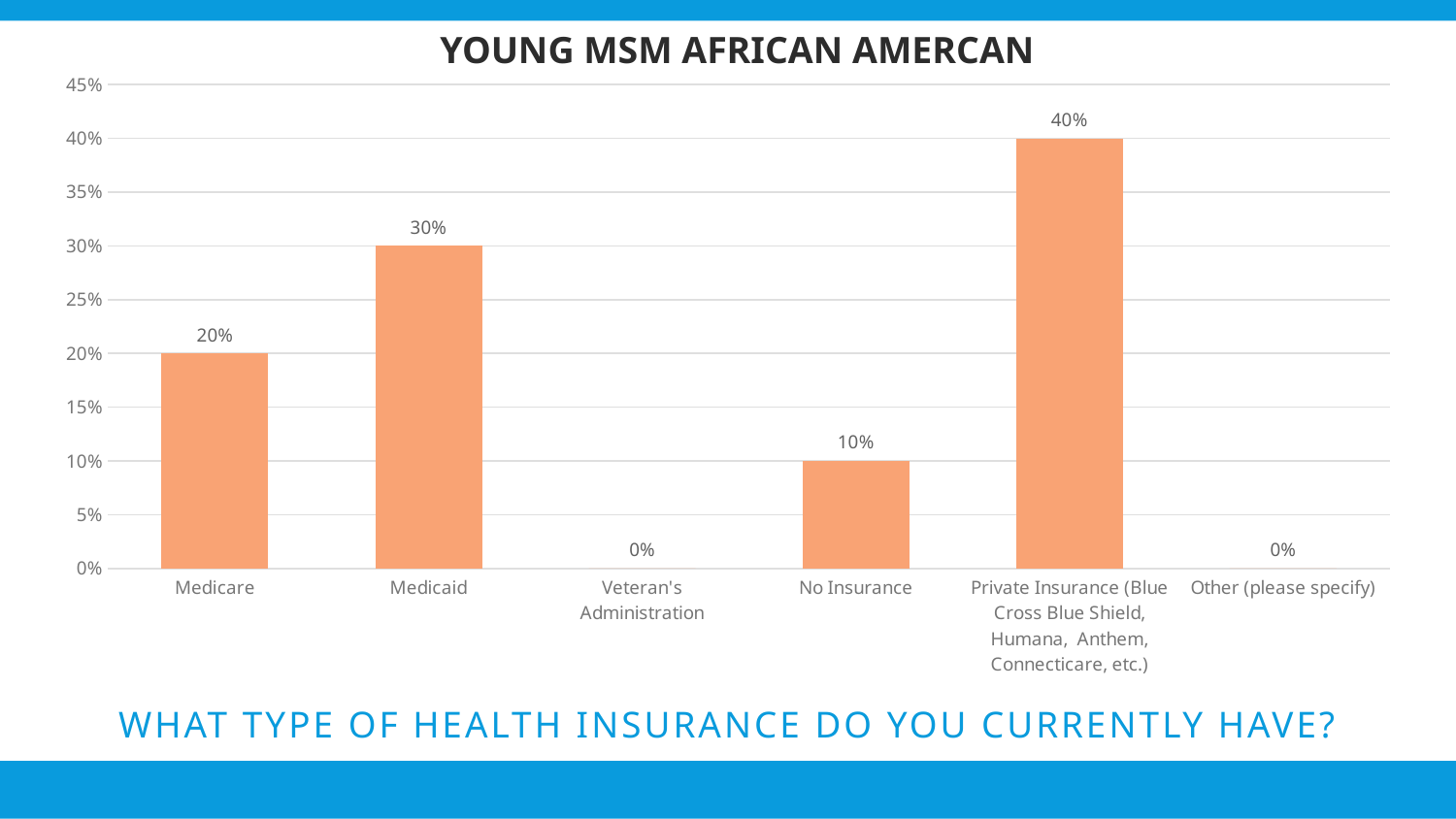
What is the value for No Insurance? 10% What is the value for Veteran's Administration? 0% What is the value for Medicaid? 30% How many categories are shown on the x axis? 6 What is the difference between the values for Private Insurance and Medicaid? 10% What kind of chart is shown on the slide? Bar chart What is the difference between the values for Medicare and No Insurance? 10% Is the value for Private Insurance greater or less than 35%? greater Which category has the highest value? Private Insurance (Blue Cross Blue Shield, Humana, Anthem, Connecticare, etc.) Which is larger, the value for Medicaid or the value for Medicare? Medicaid What is the value for Medicare? 20% What is the title of the chart? YOUNG MSM AFRICAN AMERCAN